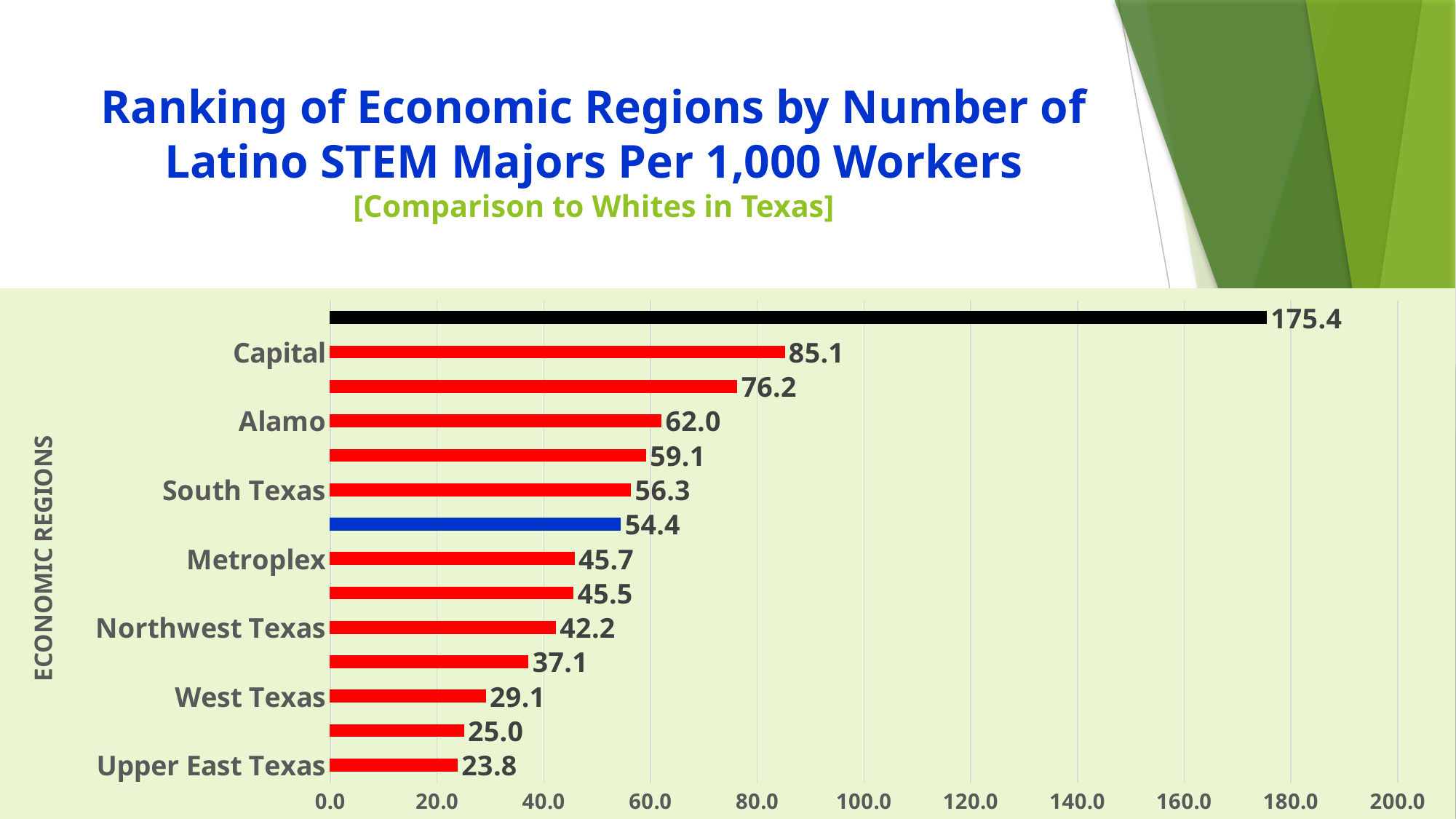
Which is larger, the value for South Texas or the value for Metroplex? South Texas What is the value for Alamo? 62.0 What is the value for South Texas? 56.3 What is the value for Metroplex? 45.7 Which labeled region has the lowest value? Upper East Texas What is the value for West Texas? 29.1 What is the largest value shown on the chart? 175.4 How many bars are plotted on the chart? 14 What is the value for Capital? 85.1 What type of chart is shown on the slide? bar chart What is the difference between the values for Capital and Alamo? 23.1 What is the value for Northwest Texas? 42.2